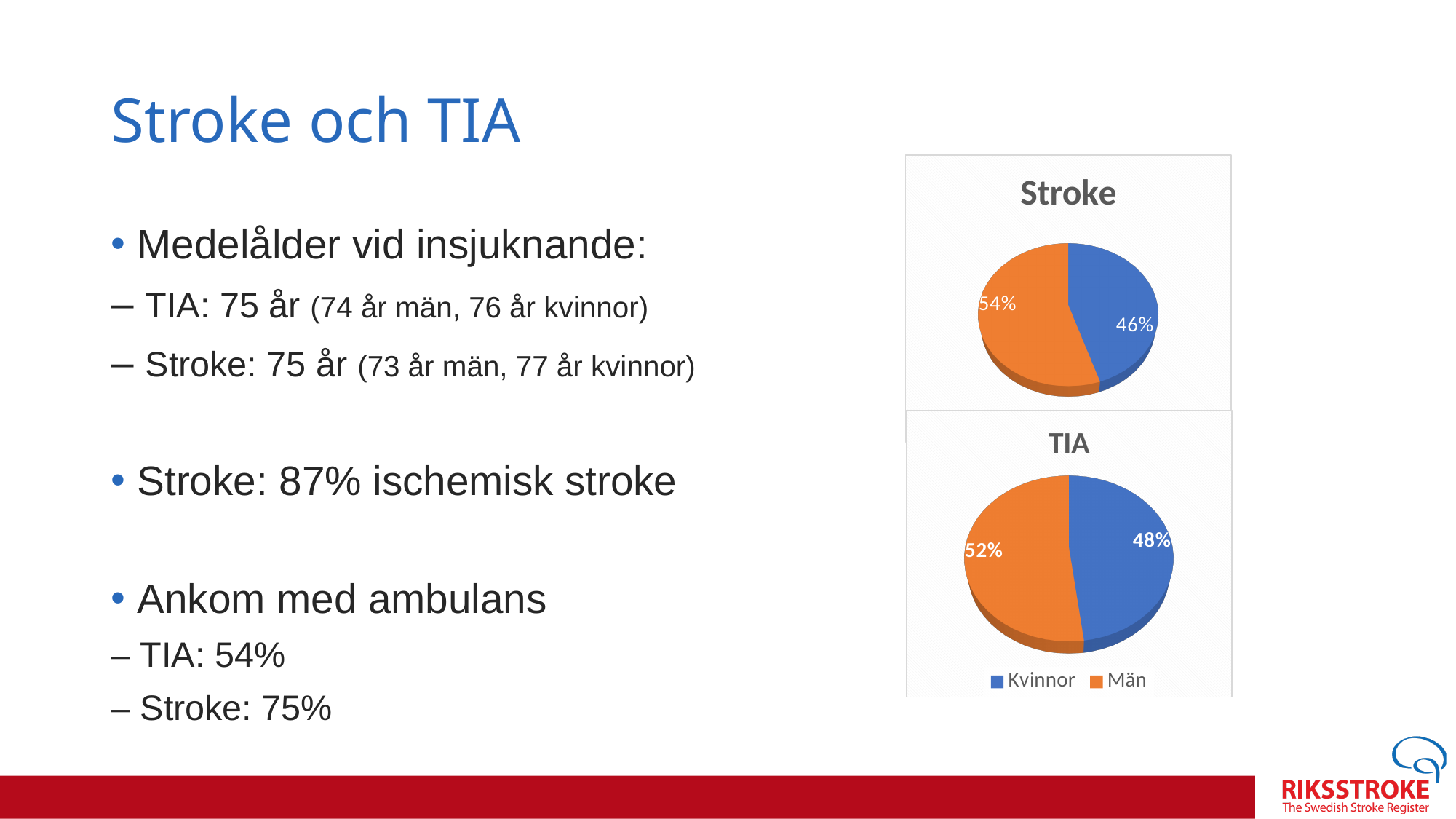
In the TIA chart, what share of the pie is Män? 52% What kind of chart is the TIA chart? Pie chart In the Stroke chart, what share of the pie is Män? 54% In the Stroke chart, which slice is larger, Kvinnor or Män? Män In the TIA chart, what is the difference in percentage points between the Män and Kvinnor slices? 4 In the Stroke chart, what share of the pie is Kvinnor? 46% In the Stroke chart, what is the difference in percentage points between the Män and Kvinnor slices? 8 In the Stroke chart, which slice is the smallest? Kvinnor How many slices does the Stroke pie chart have? 2 In the TIA chart, which slice is the largest? Män In the TIA chart, which colour represents Kvinnor? Blue